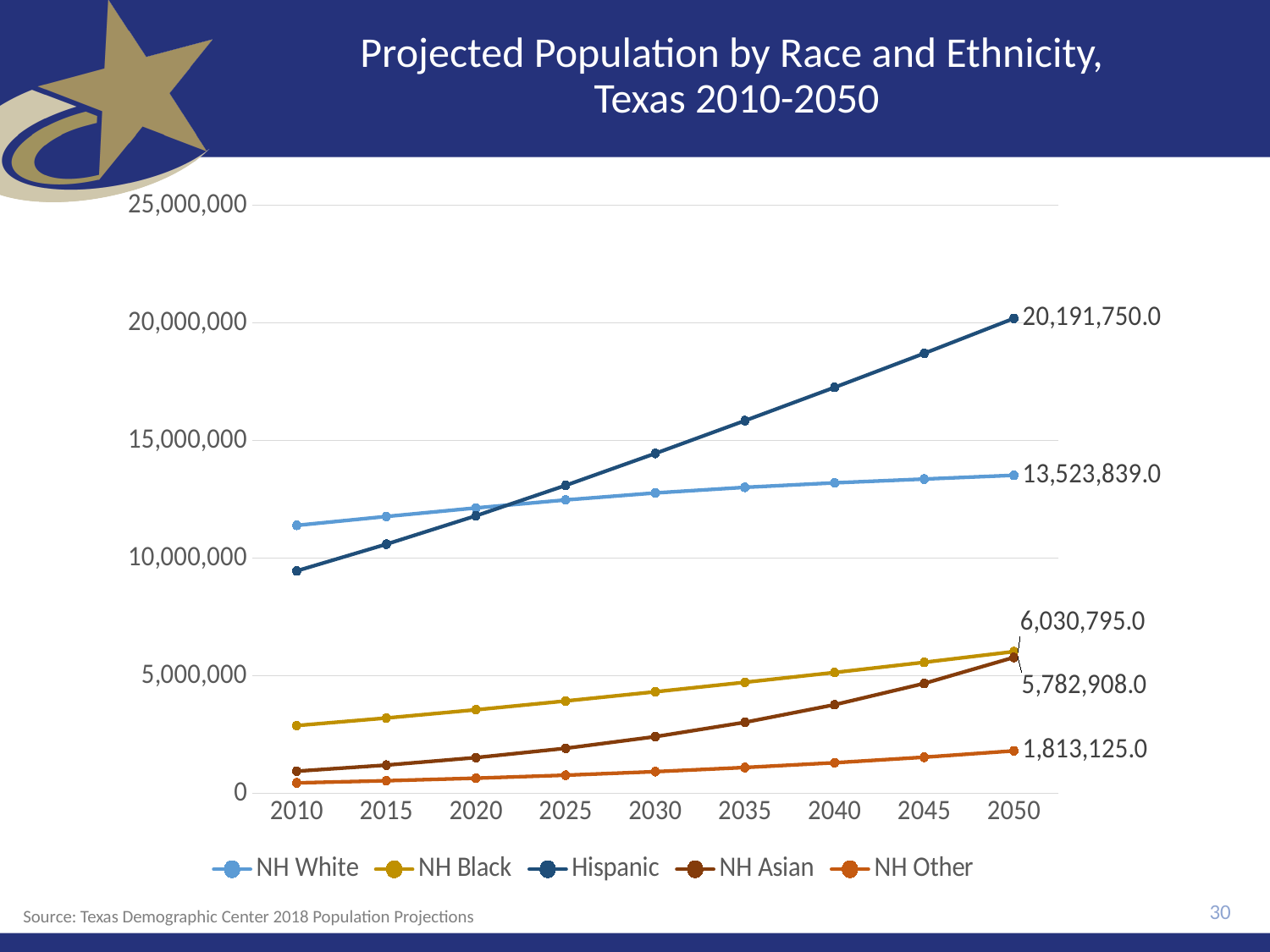
Which group has the highest projected population in 2050? Hispanic What is the projected NH Black population in Texas in 2050? 6,030,795.0 What is the projected NH White population in Texas in 2050? 13,523,839.0 How many series does the legend list? 5 Is the Hispanic population in 2010 greater or less than 10,000,000? less What type of chart is shown on the slide? line chart What is the difference between the projected Hispanic and NH White populations in 2050? 6,667,911.0 What is the projected NH Asian population in Texas in 2050? 5,782,908.0 Which group has the lowest projected population in 2050? NH Other How many years are shown on the x axis? 9 What is the projected Hispanic population in Texas in 2050? 20,191,750.0 What is the projected NH Other population in Texas in 2050? 1,813,125.0